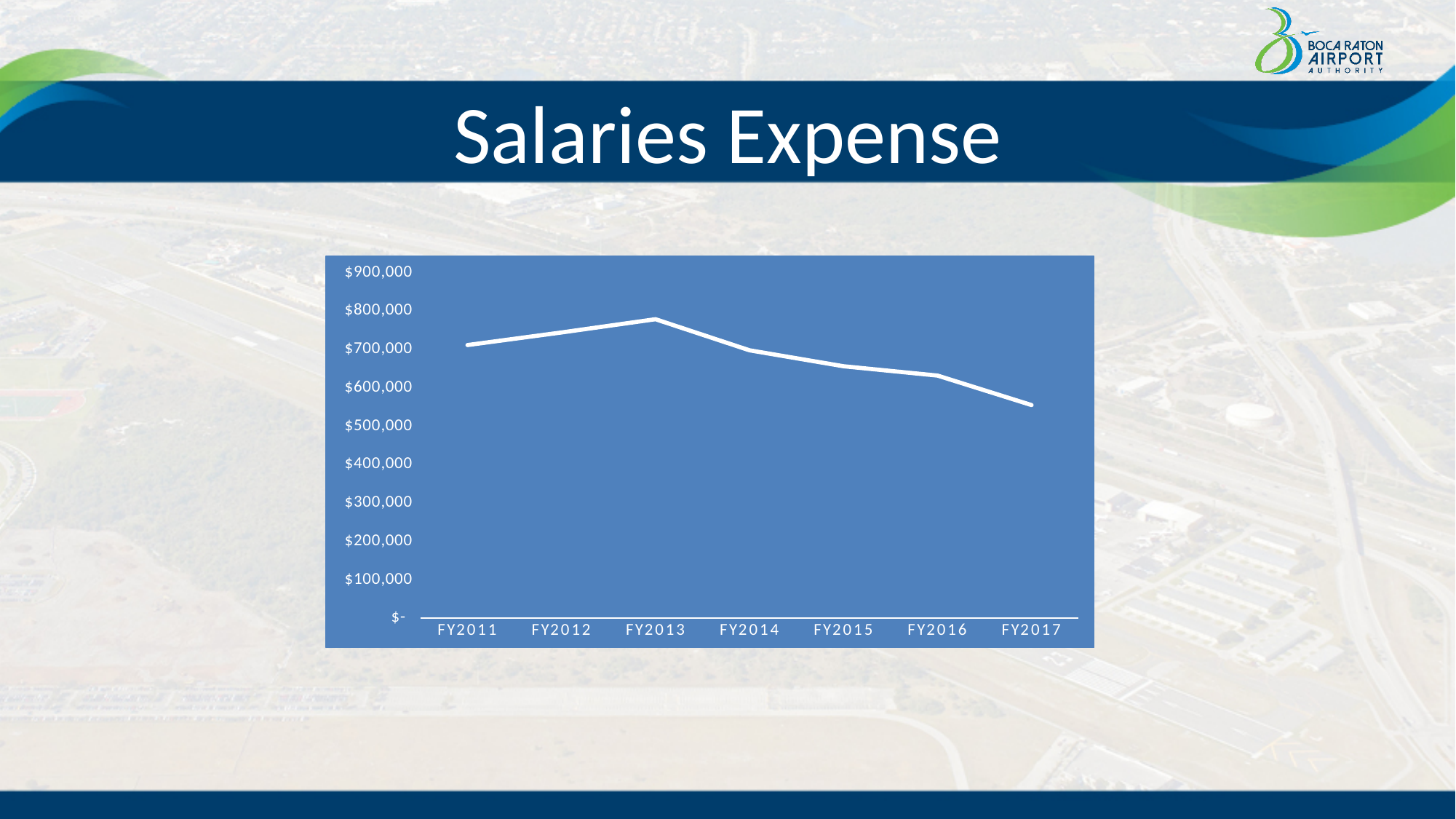
Is the value for FY2011 greater or less than $800,000? less Is the value for FY2013 greater or less than $700,000? greater Is the value for FY2016 greater or less than $600,000? greater Which fiscal year has the lowest salaries expense? FY2017 Do the values rise or fall from FY2013 to FY2017? fall What kind of chart is shown on the slide? line chart How many fiscal years are plotted on the x axis? 7 Which is larger, the value for FY2012 or the value for FY2016? FY2012 What is the title of the slide containing the chart? Salaries Expense What is the highest value labelled on the y axis? $900,000 Which fiscal year has the highest salaries expense? FY2013